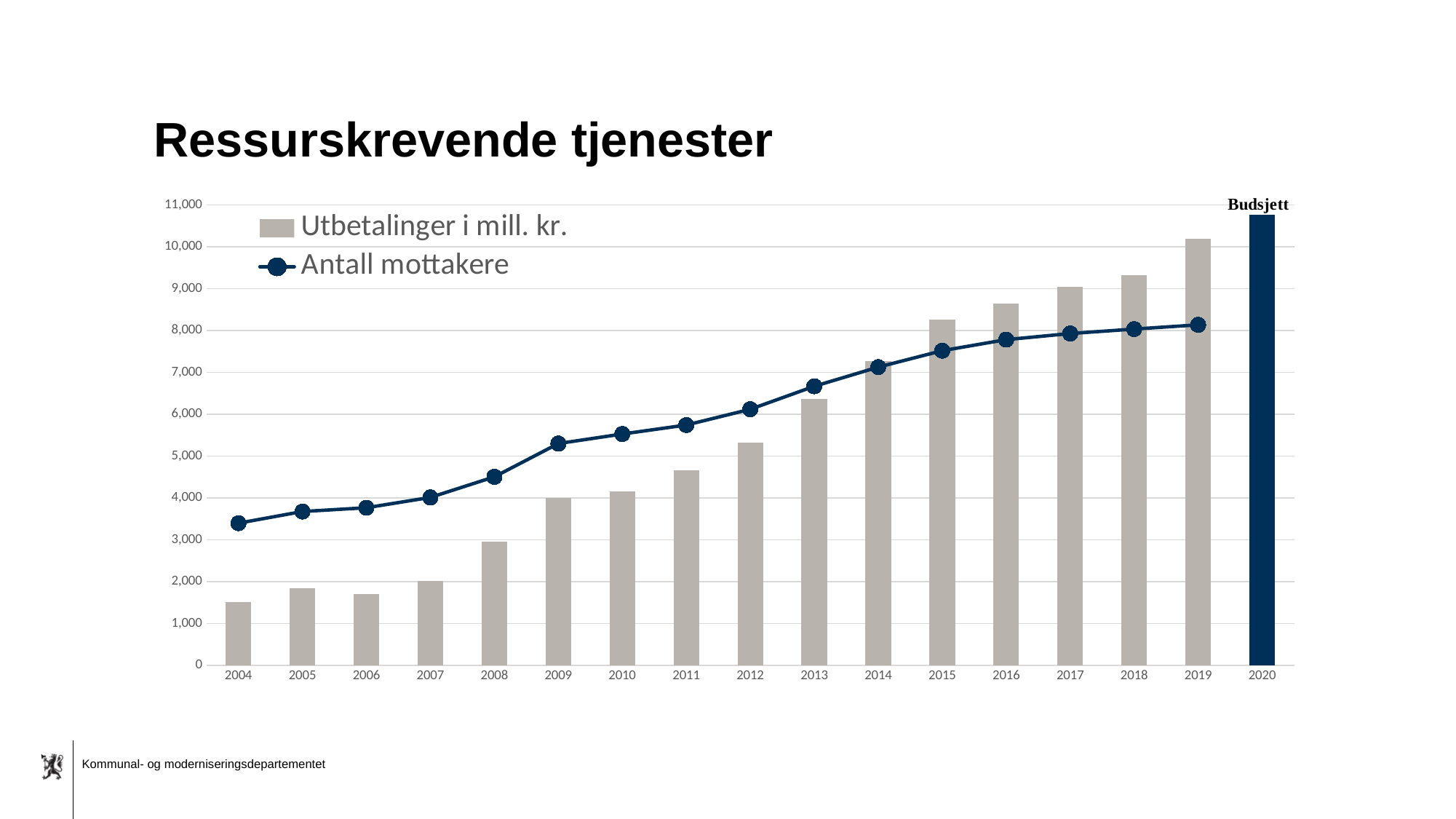
Is the Utbetalinger i mill. kr. bar for 2004 greater or less than 2,000? less Is the Antall mottakere value for 2009 greater or less than 5,000? greater How many series does the legend list? 2 How many years are shown on the x axis? 17 Do the values for Antall mottakere rise or fall from 2004 to 2019? Rise Which year has the tallest bar for Utbetalinger i mill. kr.? 2020 What label is printed above the dark blue bar for 2020? Budsjett Is the Antall mottakere value for 2016 greater or less than 8,000? less Which is larger in 2015, the Utbetalinger i mill. kr. bar or the Antall mottakere point? Utbetalinger i mill. kr. What kind of chart is shown on the slide? A combined bar and line chart Which year has the shortest bar for Utbetalinger i mill. kr.? 2004